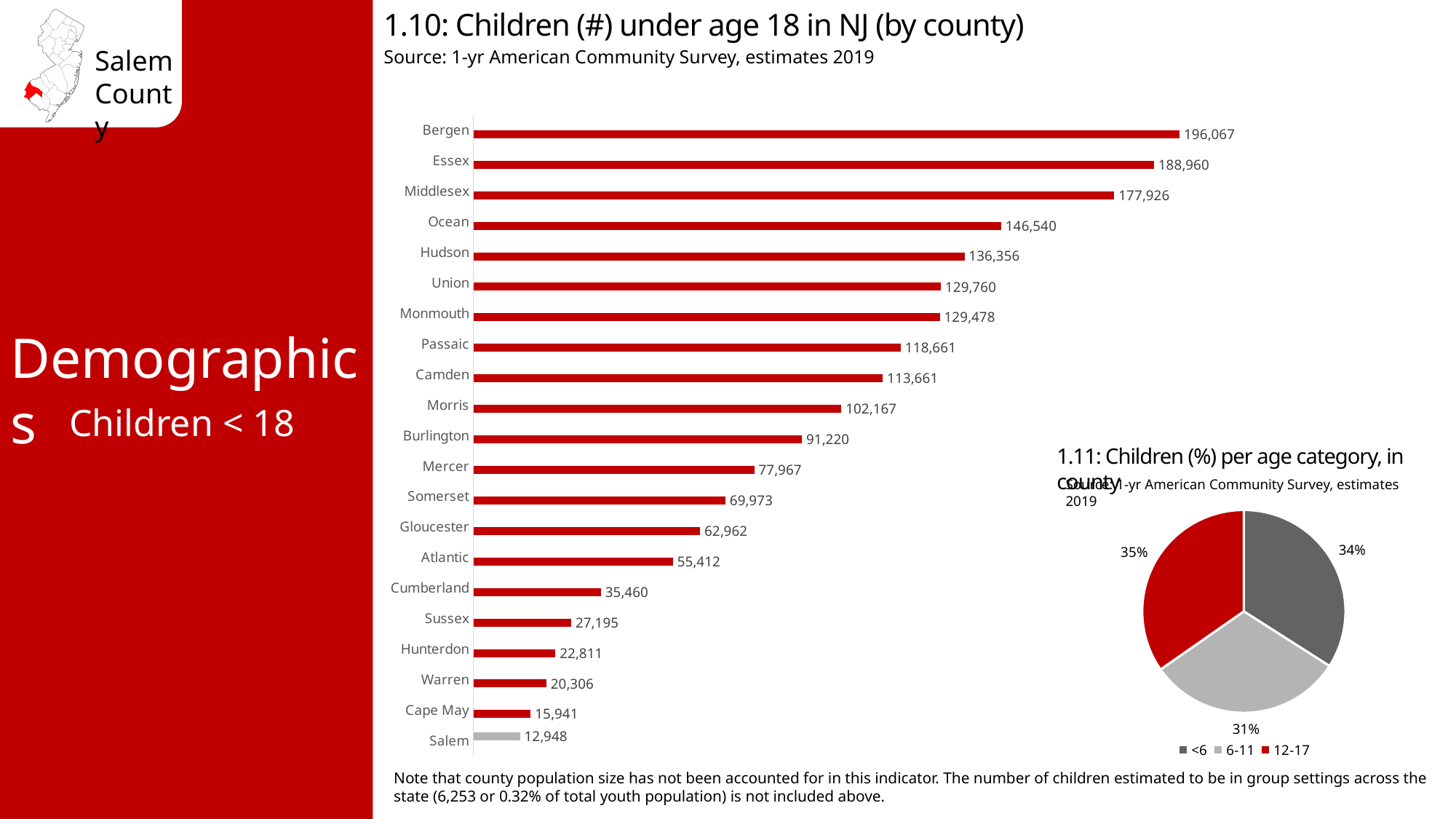
How many categories does the legend of chart 1.11 list? 3 In chart 1.11, what percentage of children are in the 6-11 age category? 31% In chart 1.10, which county has more children under 18, Camden or Morris? Camden In chart 1.10, how many counties are shown? 21 In chart 1.11, what colour is the 12-17 slice? Red In chart 1.10, which county has the lowest number of children under 18? Salem In chart 1.10, what is the value for Salem county? 12,948 In chart 1.10, how many children under age 18 are in Bergen county? 196,067 In chart 1.11, which age category has the largest share? 12-17 In chart 1.10, what is the difference between Bergen and Essex? 7,107 In chart 1.10, which county has the highest number of children under 18? Bergen What type of chart is chart 1.10? Bar chart